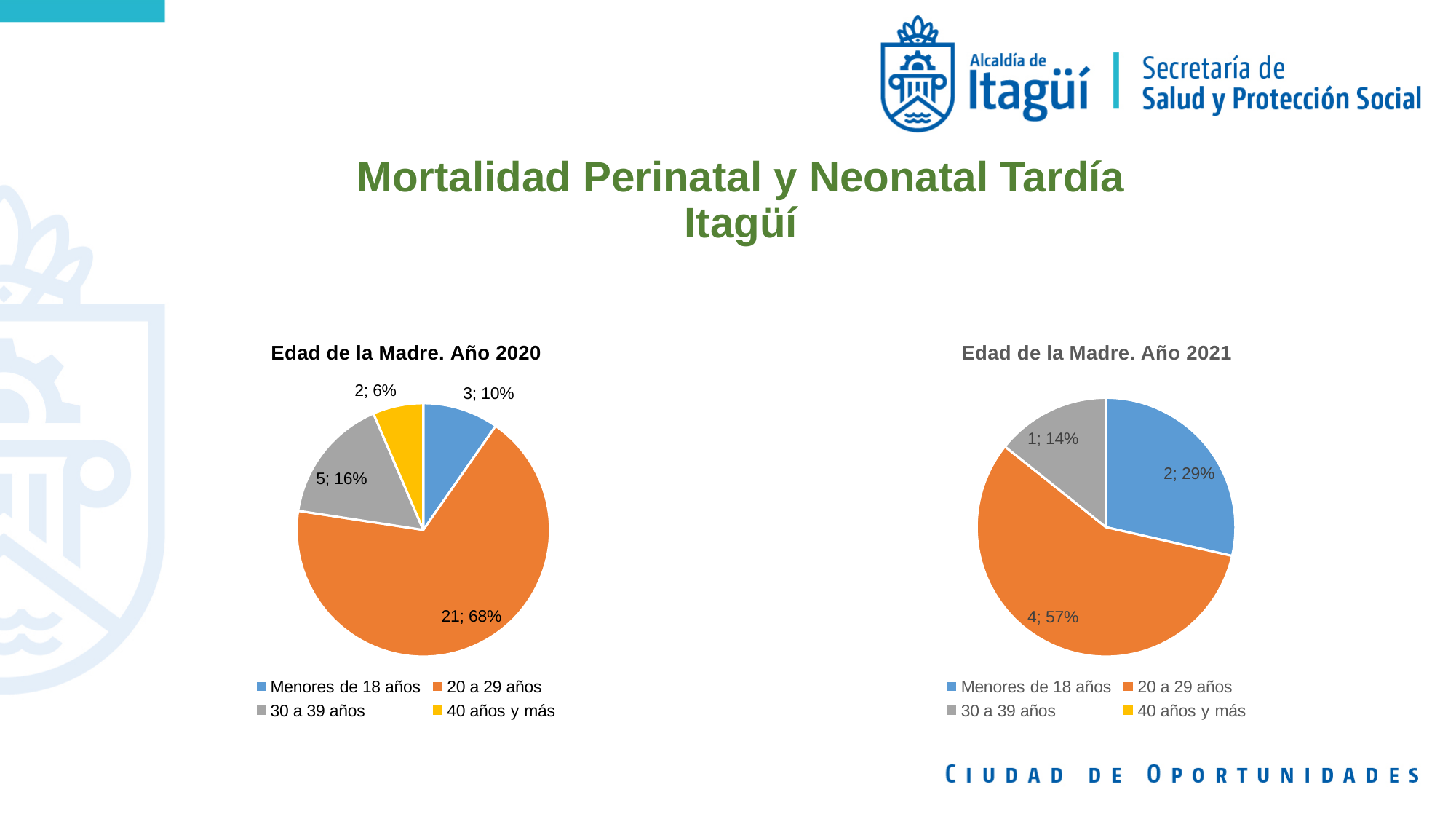
In the 'Edad de la Madre. Año 2021' chart, which is larger, the '20 a 29 años' slice or the 'Menores de 18 años' slice? 20 a 29 años In the 'Edad de la Madre. Año 2020' chart, which age group has the largest slice? 20 a 29 años How many entries does the legend of the 'Edad de la Madre. Año 2020' chart list? 4 What type of chart is used for 'Edad de la Madre. Año 2021'? Pie chart In the 'Edad de la Madre. Año 2021' chart, which age group has the largest slice? 20 a 29 años In the 'Edad de la Madre. Año 2020' chart, which age group has the smallest slice? 40 años y más In the 'Edad de la Madre. Año 2021' chart, what is the count and share for the '30 a 39 años' slice? 1; 14% In the 'Edad de la Madre. Año 2020' chart, what is the count and share for the '20 a 29 años' slice? 21; 68% In the 'Edad de la Madre. Año 2021' chart, what is the count and share for the 'Menores de 18 años' slice? 2; 29% In the 'Edad de la Madre. Año 2020' chart, what is the difference in count between '20 a 29 años' and '30 a 39 años'? 16 What share of the 'Edad de la Madre. Año 2021' pie does the '20 a 29 años' slice represent? 57% In the 'Edad de la Madre. Año 2020' chart, what is the count and share for the '40 años y más' slice? 2; 6%